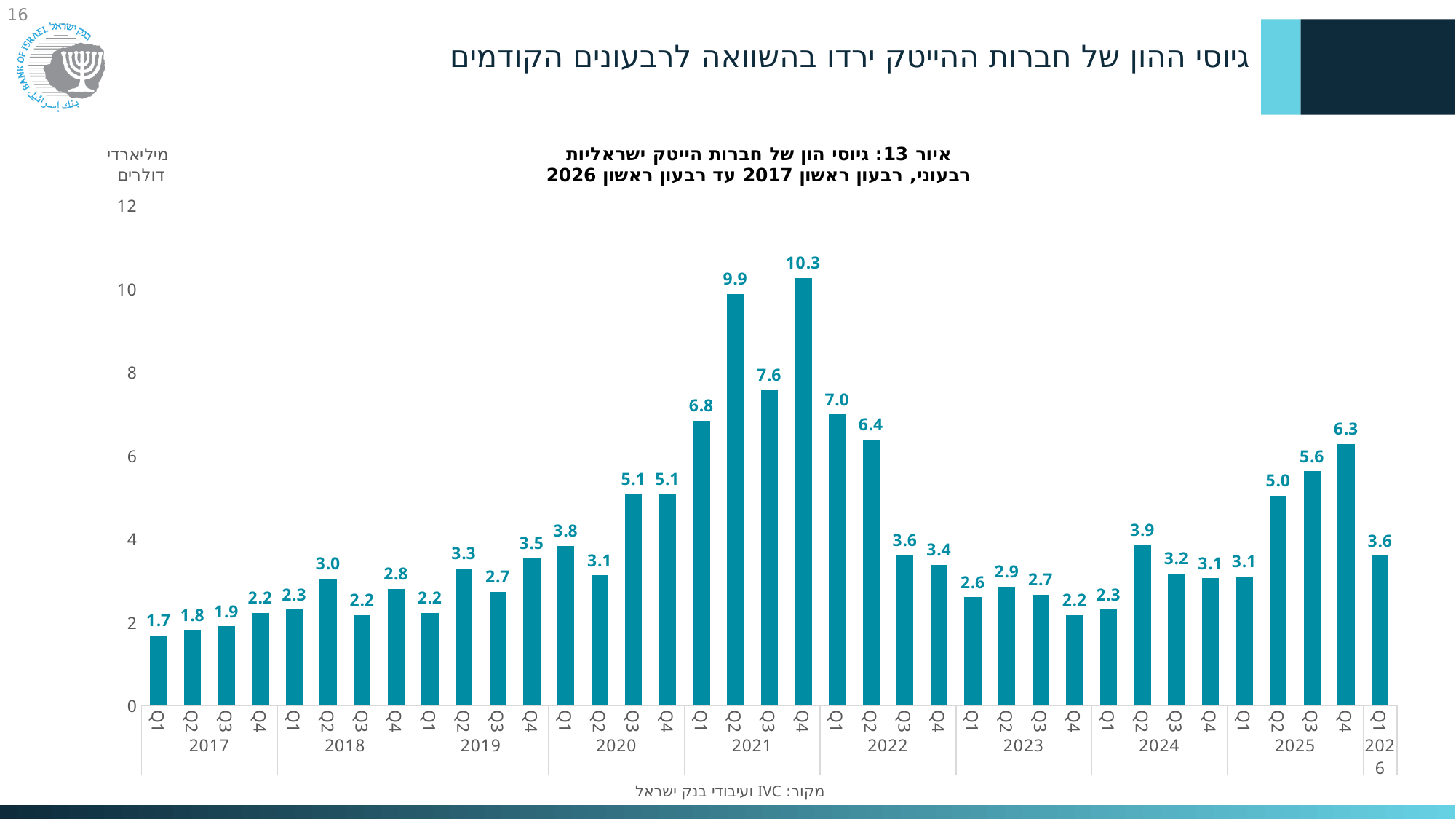
Which quarter has the lowest value? Q1 2017 How many bars are plotted in the chart? 37 Do the values rise or fall from Q1 2017 to Q4 2017? rise What is the difference between the values for Q4 2025 and Q1 2026? 2.7 What is the value for Q1 2026? 3.6 Is the value for Q2 2021 greater or less than 8? greater What kind of chart is shown on the slide? bar chart What is the value for Q2 2025? 5.0 What is the value for Q4 2021? 10.3 Which is larger, the value for Q3 2025 or the value for Q1 2022? Q1 2022 What is the difference between the values for Q2 2021 and Q4 2021? 0.4 Which quarter has the highest value? Q4 2021